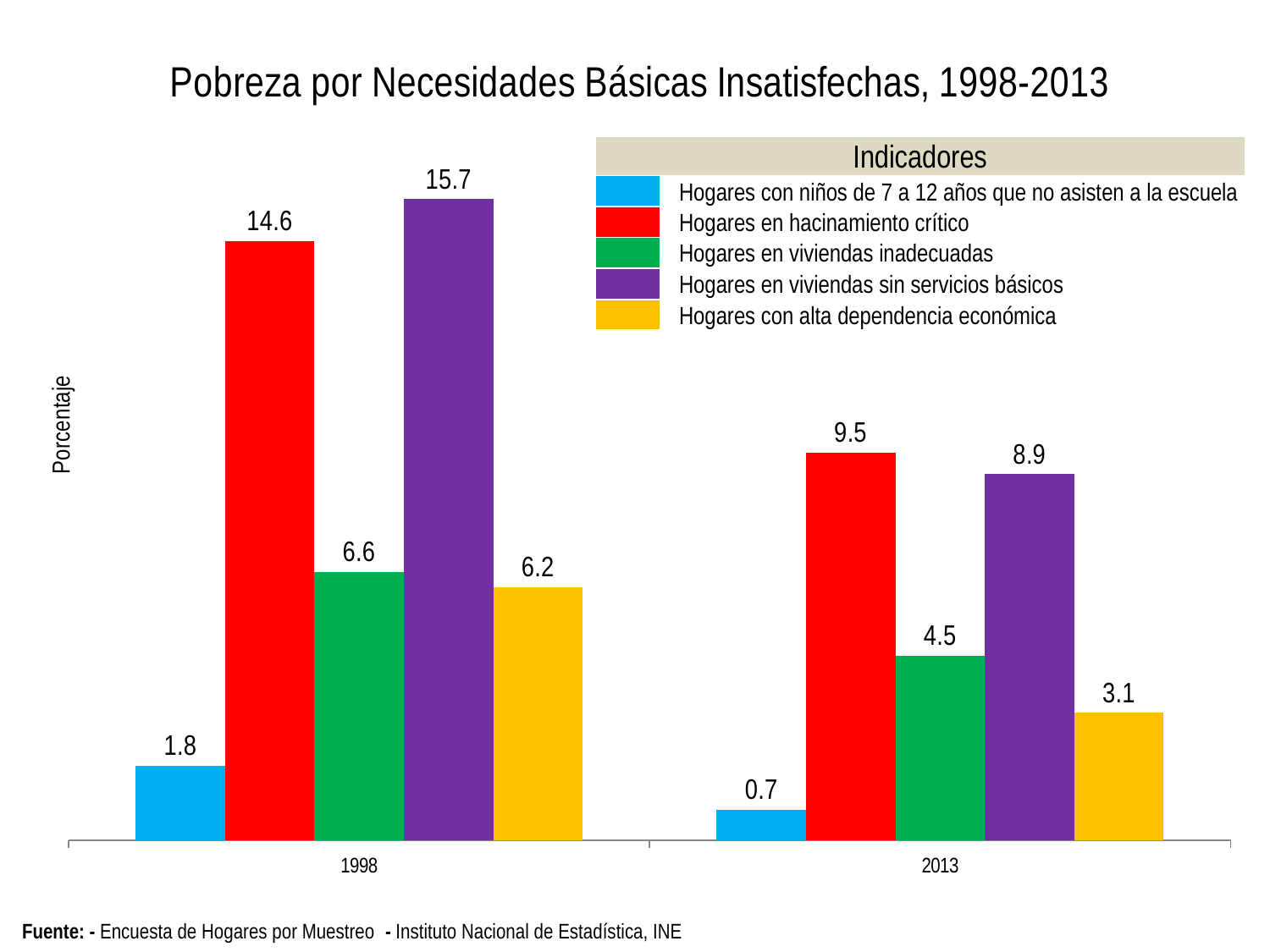
What is the value for 'Hogares en hacinamiento crítico' in 1998? 14.6 What is the difference between the 1998 and 2013 values for 'Hogares en viviendas sin servicios básicos'? 6.8 How many years (categories) are shown on the x axis? 2 What kind of chart is shown on the slide? Bar chart What is the value for 'Hogares con niños de 7 a 12 años que no asisten a la escuela' in 2013? 0.7 What is the value for 'Hogares con alta dependencia económica' in 2013? 3.1 Do the values for 'Hogares en viviendas inadecuadas' rise or fall from 1998 to 2013? Fall Which indicator has the lowest value in 2013? Hogares con niños de 7 a 12 años que no asisten a la escuela Which is larger in 2013: 'Hogares en hacinamiento crítico' or 'Hogares en viviendas sin servicios básicos'? Hogares en hacinamiento crítico Which indicator has the highest value in 1998? Hogares en viviendas sin servicios básicos What is the title of the chart? Pobreza por Necesidades Básicas Insatisfechas, 1998-2013 How many indicators does the legend list? 5